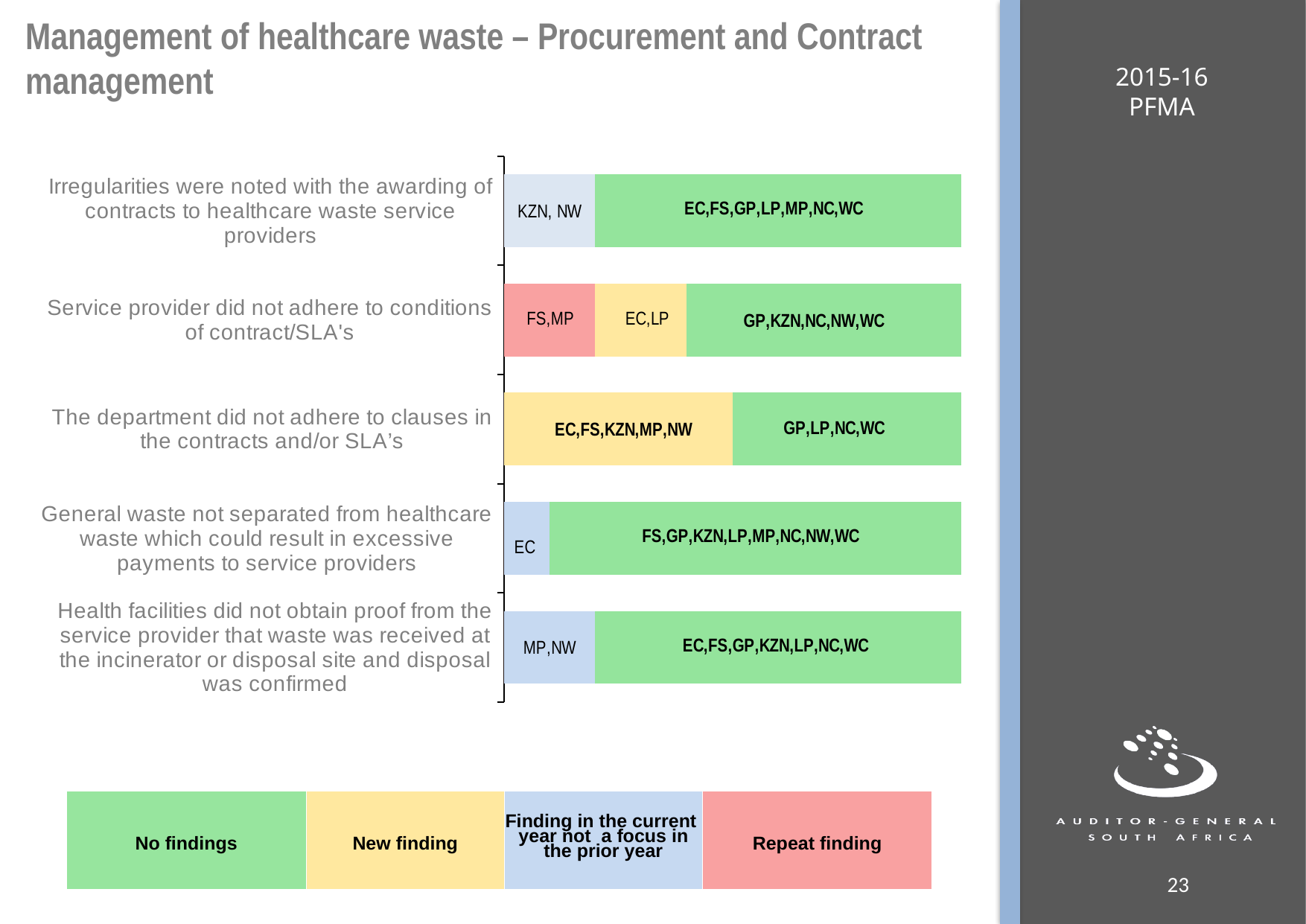
Which provinces are listed in the 'No findings' segment for 'Irregularities were noted with the awarding of contracts to healthcare waste service providers'? EC,FS,GP,LP,MP,NC,WC Which province is shown as 'Finding in the current year not a focus in the prior year' for 'General waste not separated from healthcare waste which could result in excessive payments to service providers'? EC Which provinces are listed in the 'No findings' segment for 'Health facilities did not obtain proof from the service provider that waste was received at the incinerator or disposal site and disposal was confirmed'? EC,FS,GP,KZN,LP,NC,WC What kind of chart is shown on the slide? Stacked bar chart Which provinces are shown as a 'Repeat finding' for 'Service provider did not adhere to conditions of contract/SLA's'? FS,MP What colour does the legend use for 'New finding'? Yellow Which provinces are shown as a 'New finding' for 'The department did not adhere to clauses in the contracts and/or SLA's'? EC,FS,KZN,MP,NW How many finding categories (bars) are shown in the chart? 5 Which finding category has the most provinces with 'No findings'? General waste not separated from healthcare waste which could result in excessive payments to service providers How many finding types does the legend list? 4 Which finding category has the fewest provinces with 'No findings'? The department did not adhere to clauses in the contracts and/or SLA's Which finding category is the only one with a 'Repeat finding' segment? Service provider did not adhere to conditions of contract/SLA's